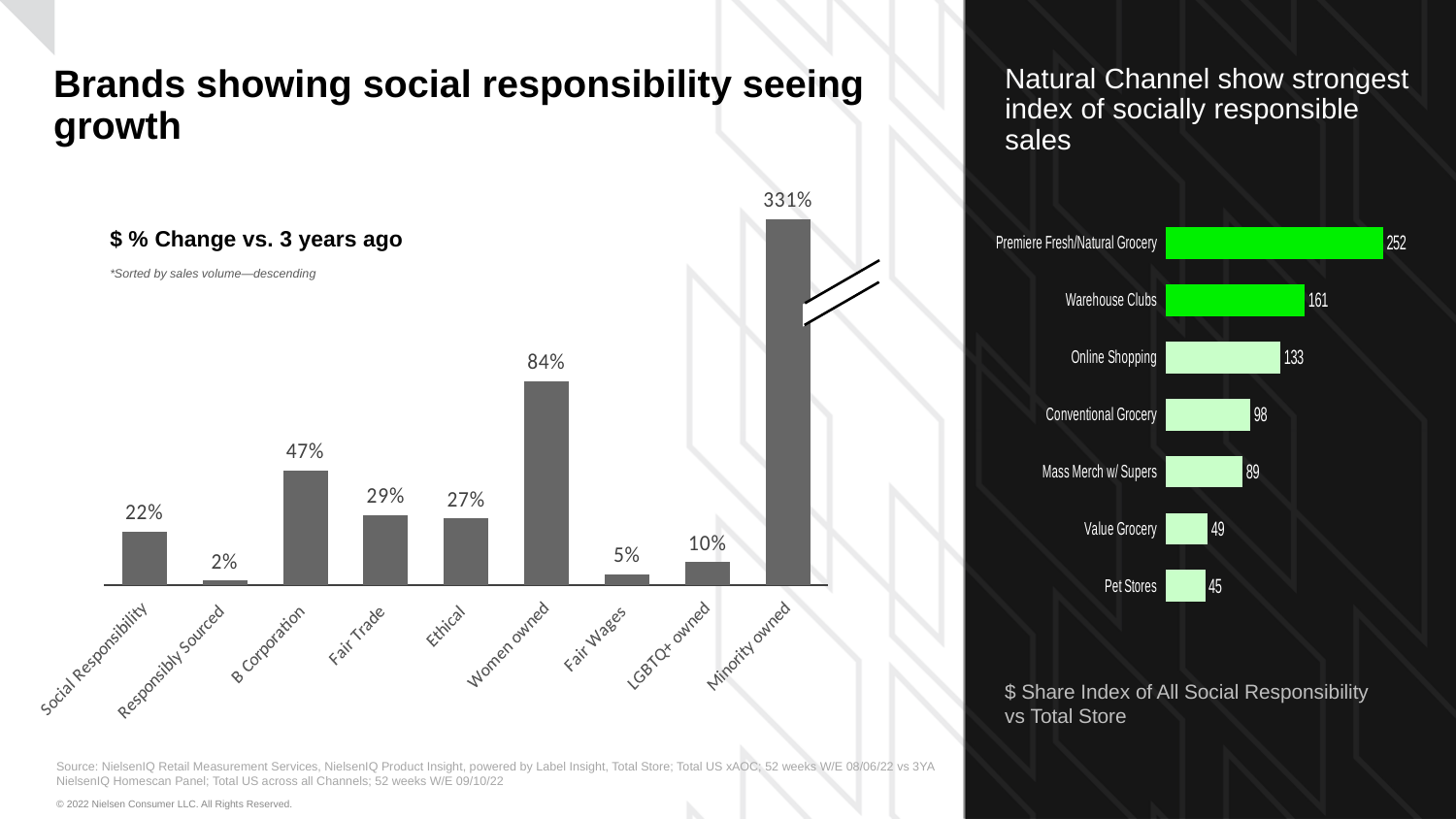
How many categories are shown in the "$ % Change vs. 3 years ago" chart? 9 In the "$ % Change vs. 3 years ago" chart, which is larger, LGBTQ+ owned or Fair Wages? LGBTQ+ owned In the "$ Share Index of All Social Responsibility vs Total Store" chart on the right, which channel has the lowest index? Pet Stores In the "$ % Change vs. 3 years ago" chart, what is the difference between Fair Trade and Ethical? 2% In the "$ Share Index of All Social Responsibility vs Total Store" chart on the right, what is the difference between Premiere Fresh/Natural Grocery and Conventional Grocery? 154 In the "$ % Change vs. 3 years ago" chart, what is the value for B Corporation? 47% In the "$ Share Index of All Social Responsibility vs Total Store" chart on the right, what is the value for Warehouse Clubs? 161 How many channels are shown in the "$ Share Index of All Social Responsibility vs Total Store" chart on the right? 7 What kind of chart is the "$ % Change vs. 3 years ago" chart? Bar chart In the "$ % Change vs. 3 years ago" chart, which category has the lowest value? Responsibly Sourced In the "$ % Change vs. 3 years ago" chart, what is the value for Women owned? 84% In the "$ % Change vs. 3 years ago" chart, which category has the highest value? Minority owned